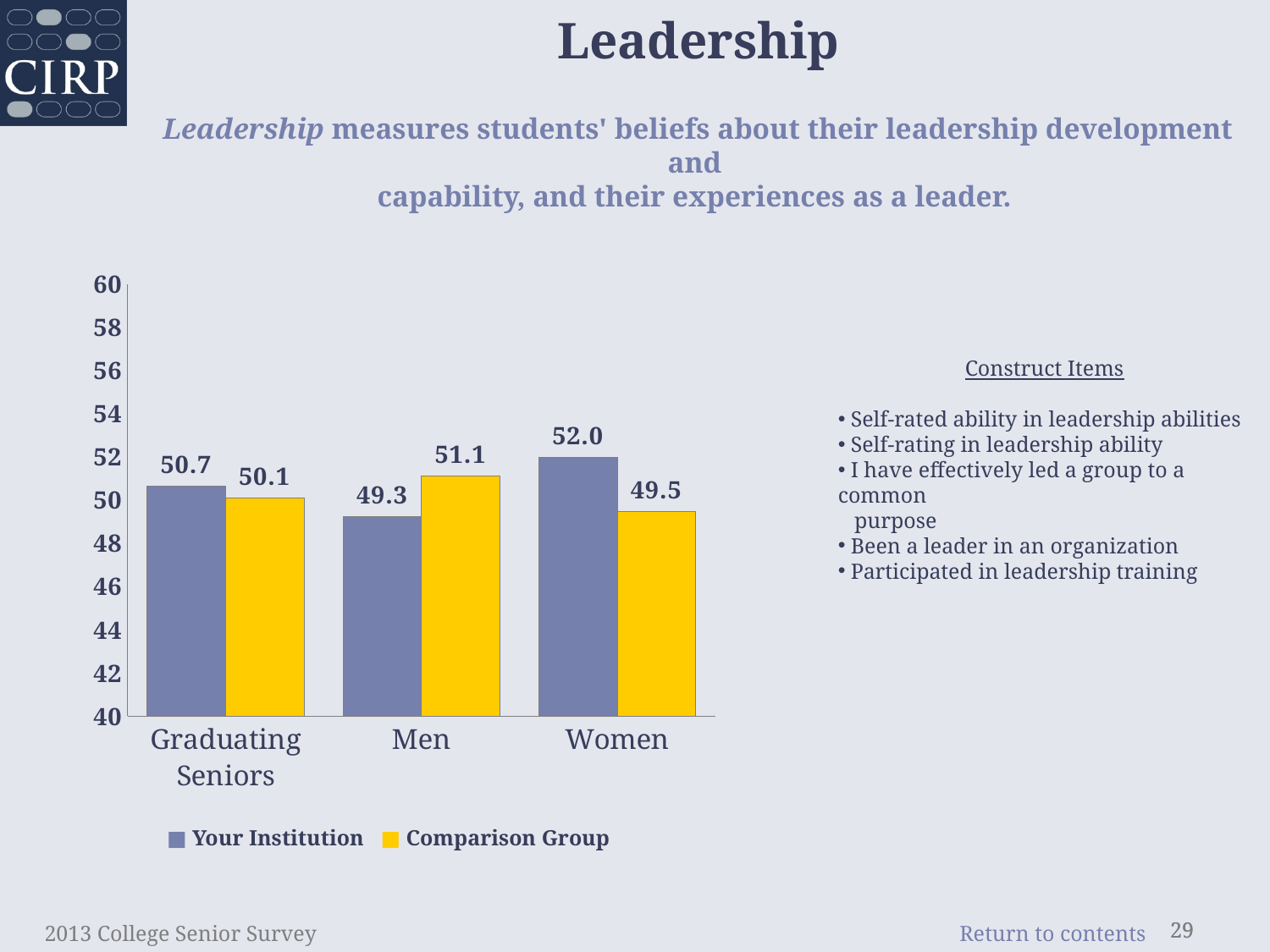
Which category has the highest Your Institution value? Women What colour are the Comparison Group bars? yellow What is the difference between the Your Institution and Comparison Group values for Women? 2.5 How many series does the legend list? 2 What kind of chart is shown on the slide? bar chart For Men, which is larger: Your Institution or Comparison Group? Comparison Group Which category has the lowest Comparison Group value? Women Is the Your Institution value for Men greater or less than 50? less What is the Your Institution value for Women? 52.0 How many categories are shown on the x axis? 3 What is the Your Institution value for Graduating Seniors? 50.7 What is the Comparison Group value for Men? 51.1